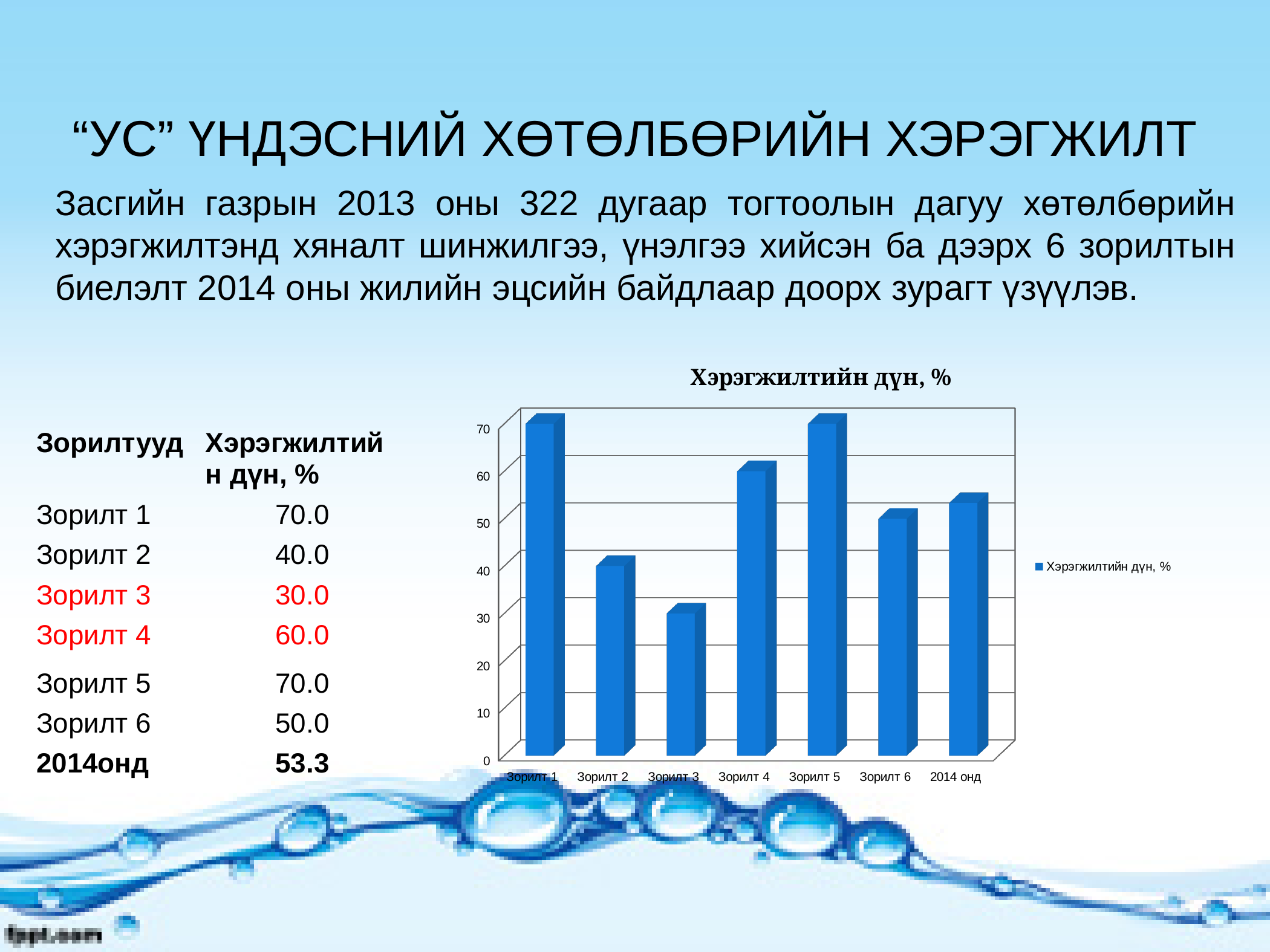
Is the value for Зорилт 6 greater or less than 40? greater What is the value for Зорилт 4? 60.0 What is the value for 2014 онд? 53.3 Which is larger, the value for Зорилт 4 or the value for Зорилт 6? Зорилт 4 What is the title of the chart? Хэрэгжилтийн дүн, % How many series does the chart legend list? 1 What type of chart is shown on the slide? bar chart Is the value for Зорилт 3 greater or less than 40? less What is the difference between the values for Зорилт 1 and Зорилт 3? 40.0 How many bars (categories) does the chart show? 7 What is the value for Зорилт 2? 40.0 Which category has the lowest value? Зорилт 3